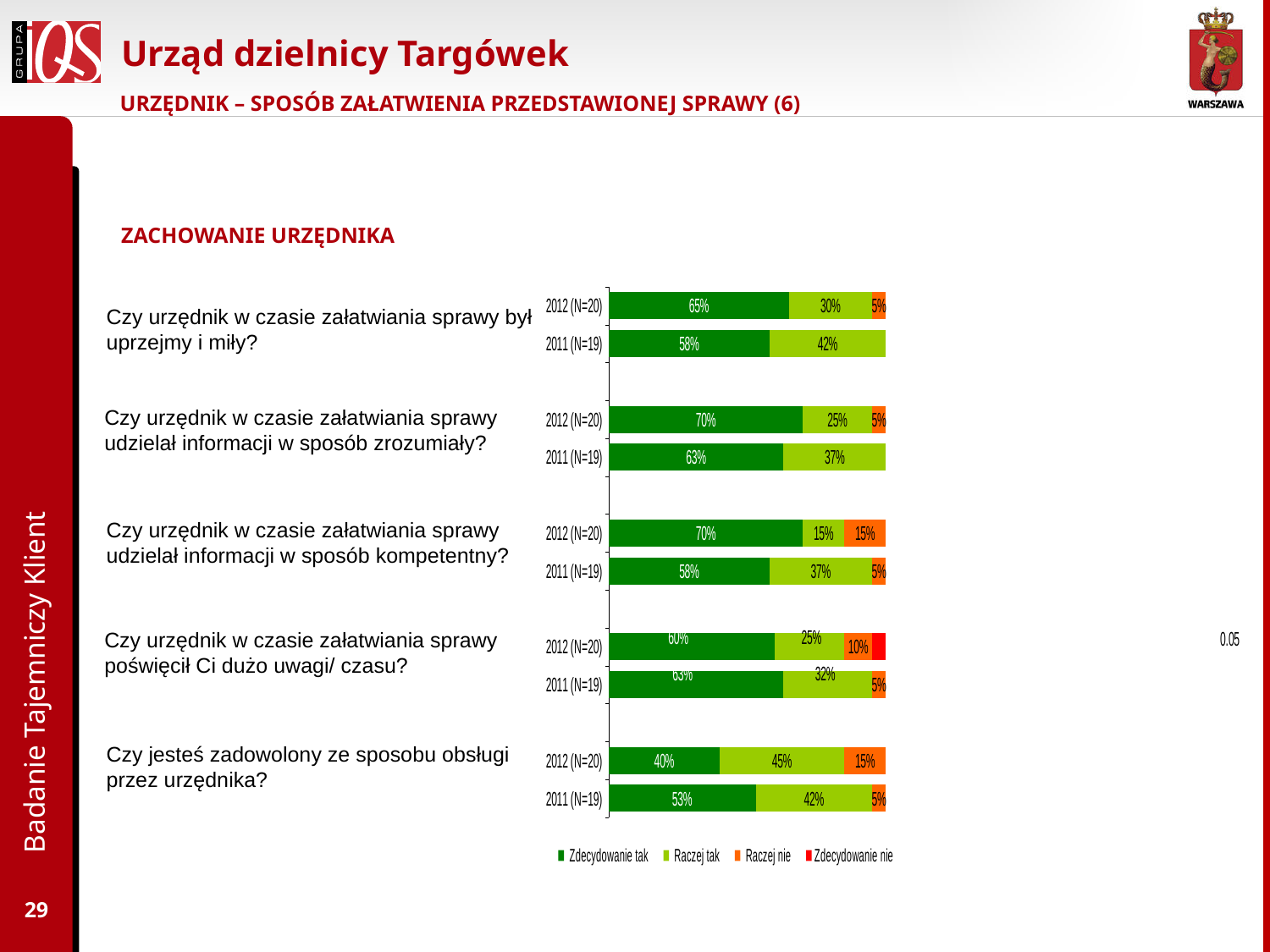
Which bar has the lowest 'Zdecydowanie tak' value in the chart? 2012 (N=20) for 'Czy jesteś zadowolony ze sposobu obsługi przez urzędnika?' What is the 'Zdecydowanie tak' value for 2012 (N=20) for the question 'Czy urzędnik w czasie załatwiania sprawy był uprzejmy i miły?' 65% What type of chart is shown on the slide? stacked bar chart What is the 'Raczej tak' value for 2011 (N=19) for the question 'Czy urzędnik w czasie załatwiania sprawy był uprzejmy i miły?' 42% How many series does the chart legend list? 4 What is the 'Raczej tak' value for 2011 (N=19) for the question 'Czy urzędnik w czasie załatwiania sprawy poświęcił Ci dużo uwagi/ czasu?' 32% For the question 'Czy urzędnik w czasie załatwiania sprawy udzielał informacji w sposób zrozumiały?', what is the difference between the 'Zdecydowanie tak' values for 2012 (N=20) and 2011 (N=19)? 7% What is the last entry listed in the chart legend? Zdecydowanie nie What is the 'Zdecydowanie tak' value for 2012 (N=20) for the question 'Czy jesteś zadowolony ze sposobu obsługi przez urzędnika?' 40% For the question 'Czy jesteś zadowolony ze sposobu obsługi przez urzędnika?', which year has the larger 'Zdecydowanie tak' value, 2012 (N=20) or 2011 (N=19)? 2011 (N=19) How many bars are plotted in the chart in total? 10 What is the 'Raczej nie' value for 2012 (N=20) for the question 'Czy urzędnik w czasie załatwiania sprawy udzielał informacji w sposób kompetentny?' 15%